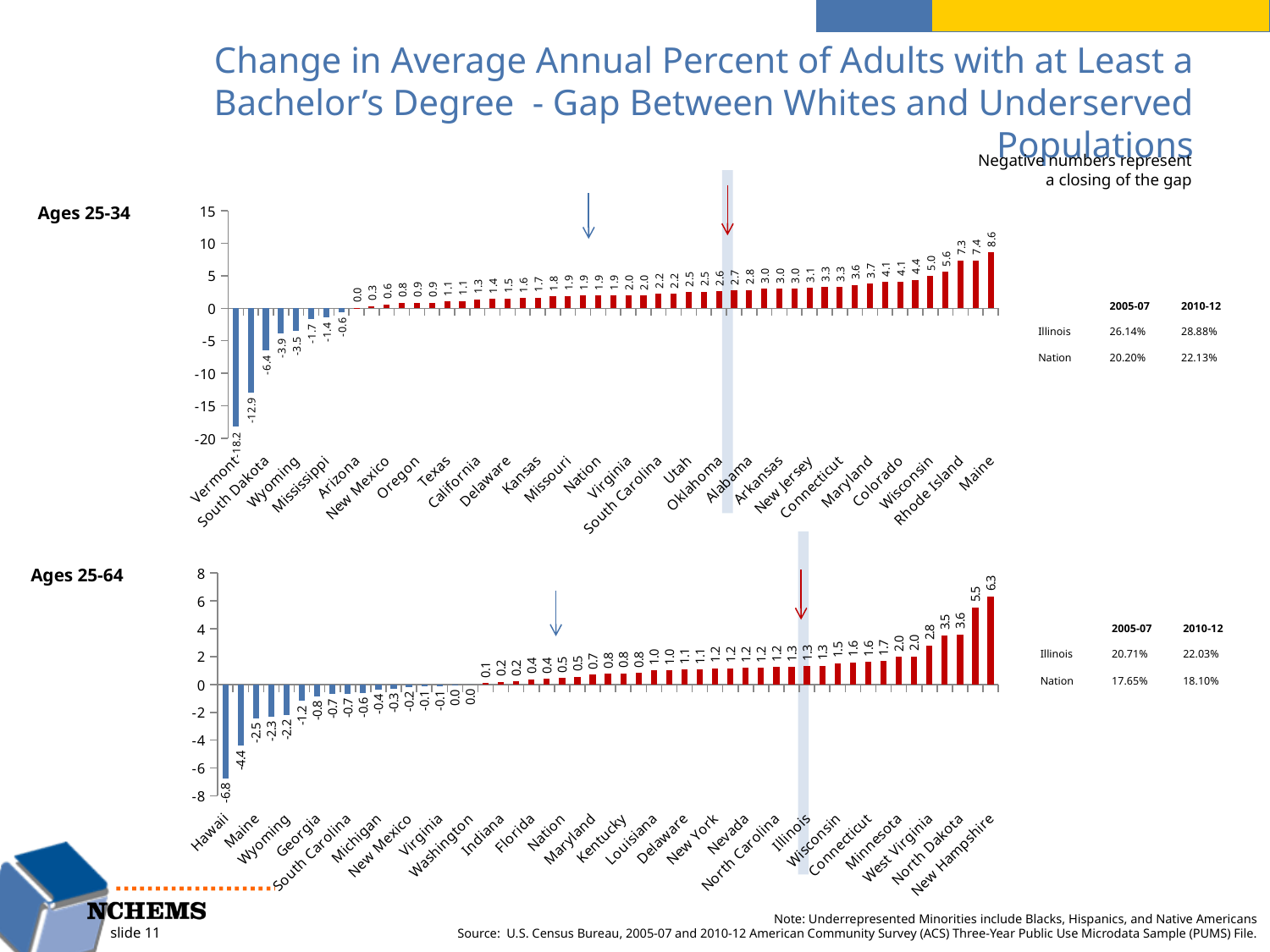
In the Ages 25-64 chart, what is the value for New Hampshire? 6.3 In the Ages 25-34 chart, what is the value for Maine? 8.6 In the Ages 25-64 chart, what is the value for Illinois? 1.3 In the Ages 25-64 chart, which is larger, the value for Hawaii or the value for New Hampshire? New Hampshire In the Ages 25-34 chart, which state has the highest value? Maine In the Ages 25-64 chart, which state has the lowest value? Hawaii What type of chart is used on this slide for the Ages 25-34 and Ages 25-64 data? Bar chart In the Ages 25-34 chart, which state has the lowest value? Vermont In the Ages 25-34 chart, what is the value for Vermont? -18.2 In the Ages 25-34 chart, what is the difference between the values for Maine and Vermont? 26.8 In the Ages 25-64 chart, do the values rise or fall moving from left to right along the x axis? Rise According to the note on the slide, what do negative numbers represent? A closing of the gap